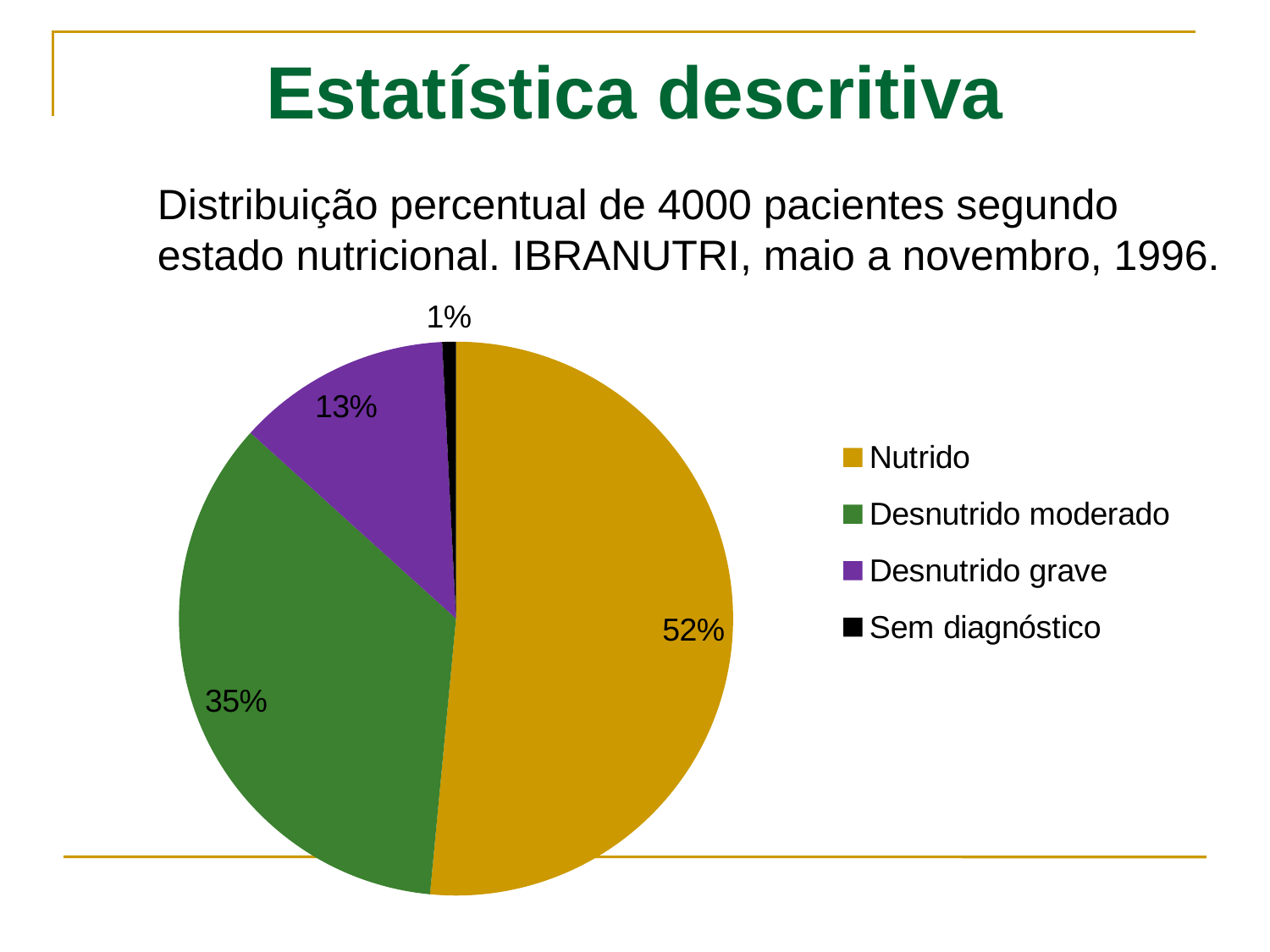
What colour is the Desnutrido grave slice? purple What is the difference in percentage points between Nutrido and Desnutrido moderado? 17 How many categories does the pie chart show? 4 What kind of chart is shown on the slide? pie chart What percentage of patients are Nutrido? 52% What percentage of patients are Desnutrido moderado? 35% What percentage of patients are Desnutrido grave? 13% Which category has the smallest share of the pie? Sem diagnóstico Which category has the largest share of the pie? Nutrido Which is larger, the share for Desnutrido moderado or the share for Desnutrido grave? Desnutrido moderado What percentage of patients are Sem diagnóstico? 1% How many patients does the chart caption say the distribution is based on? 4000